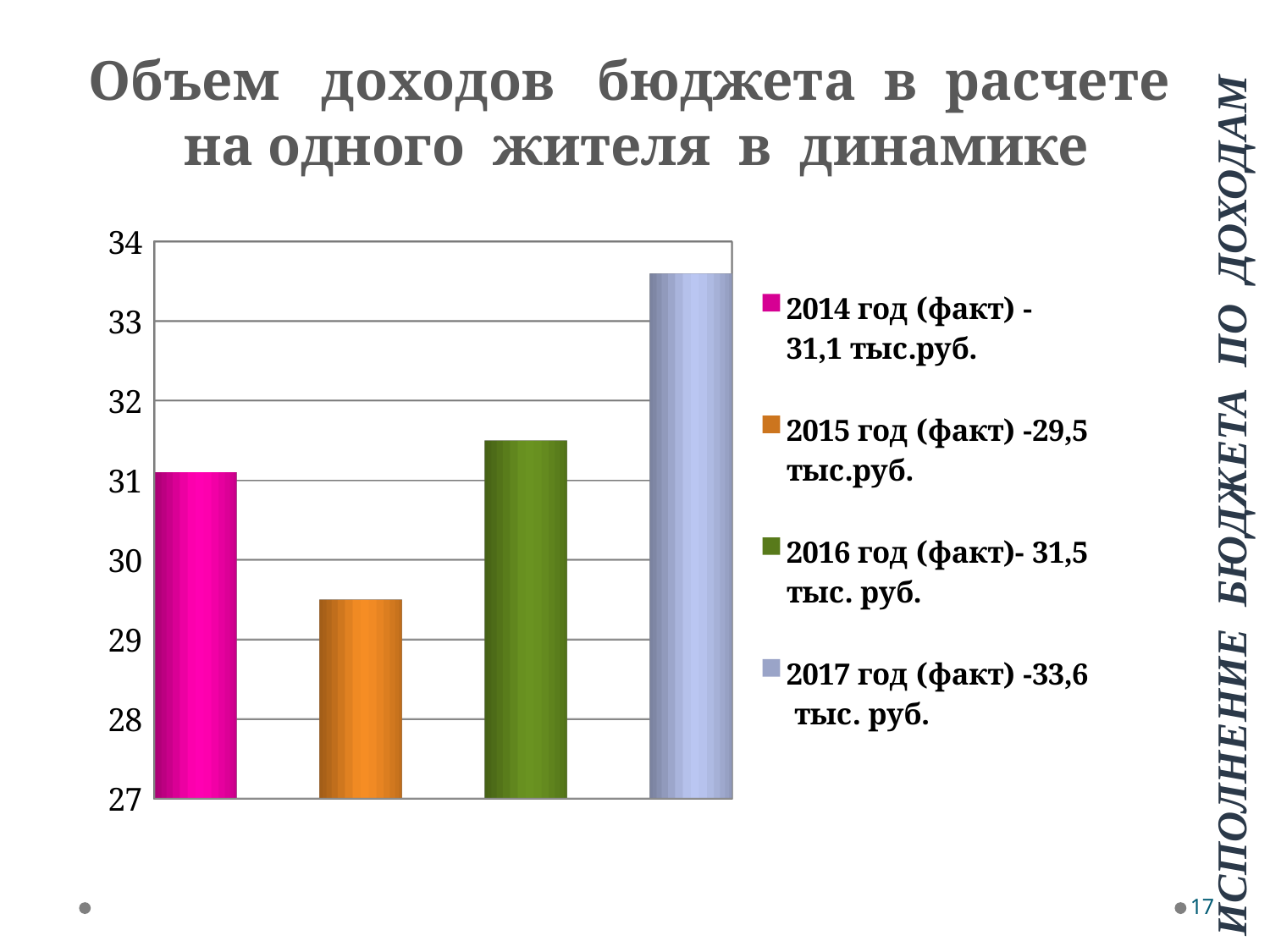
What is the budget revenue per resident for 2015 (факт)? 29,5 тыс.руб. What kind of chart is shown on the slide? bar chart Which year has the lowest budget revenue per resident? 2015 Which year has the highest budget revenue per resident? 2017 How many bars are plotted in the chart? 4 What is the budget revenue per resident for 2014 (факт)? 31,1 тыс.руб. How many entries does the legend list? 4 Which is larger, the value for 2016 or the value for 2014? 2016 What is the budget revenue per resident for 2017 (факт)? 33,6 тыс. руб. What is the difference between the 2017 and 2015 values? 4,1 тыс. руб. What is the difference between the 2016 and 2014 values? 0,4 тыс. руб. Is the value for 2015 greater or less than 30? less